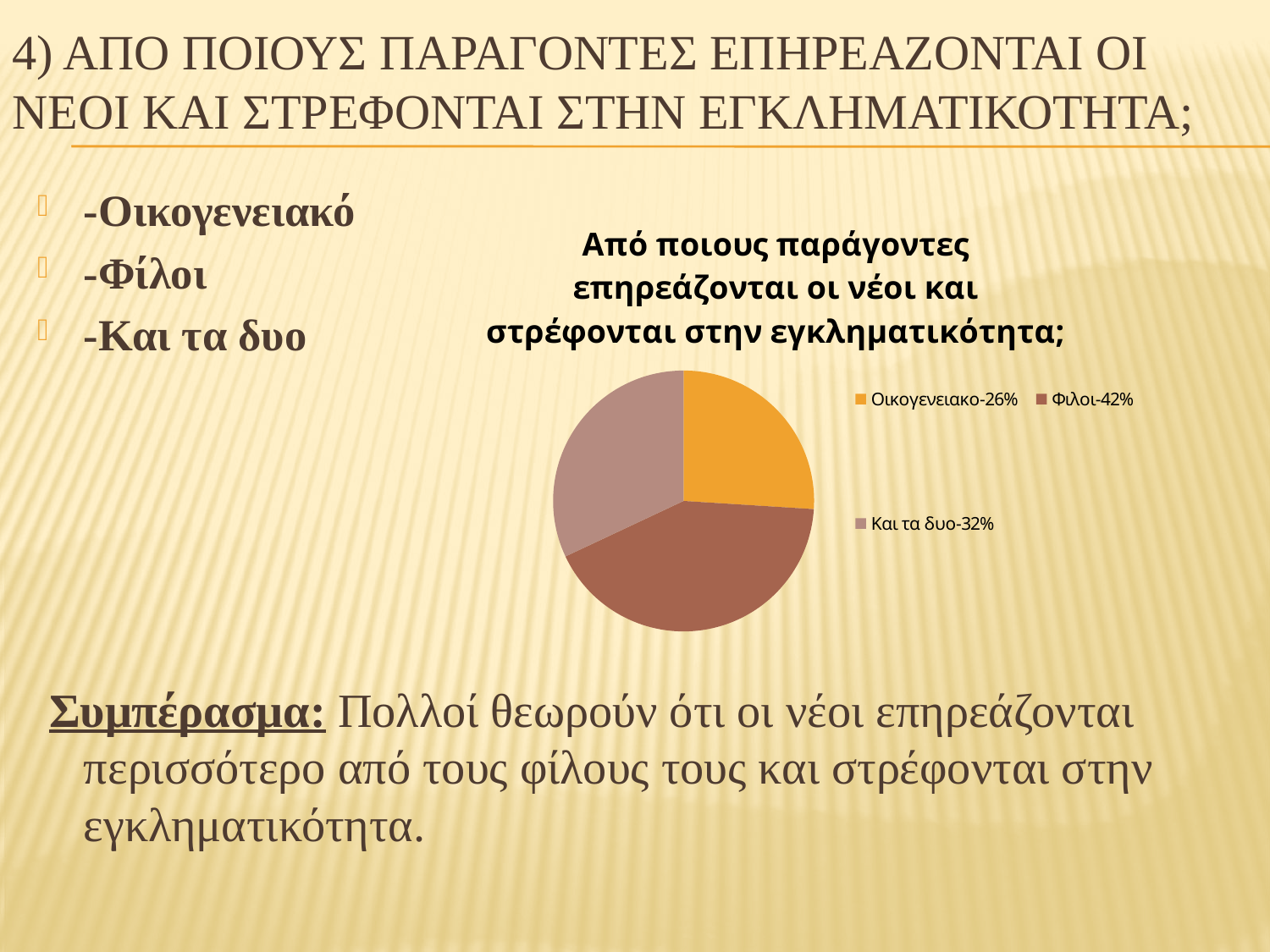
What percentage does the legend give for Και τα δυο? 32% How many entries does the legend list? 3 What is the difference in percentage points between Φιλοι and Και τα δυο? 10 How many slices does the pie chart have? 3 What percentage does the legend give for Φιλοι? 42% Which is larger, the share for Και τα δυο or the share for Οικογενειακο? Και τα δυο What colour is the slice for Φιλοι? brown What is the difference in percentage points between Φιλοι and Οικογενειακο? 16 Which category has the smallest share of the pie? Οικογενειακο What kind of chart is shown on the slide? pie chart Which category has the largest share of the pie? Φιλοι What percentage does the legend give for Οικογενειακο? 26%